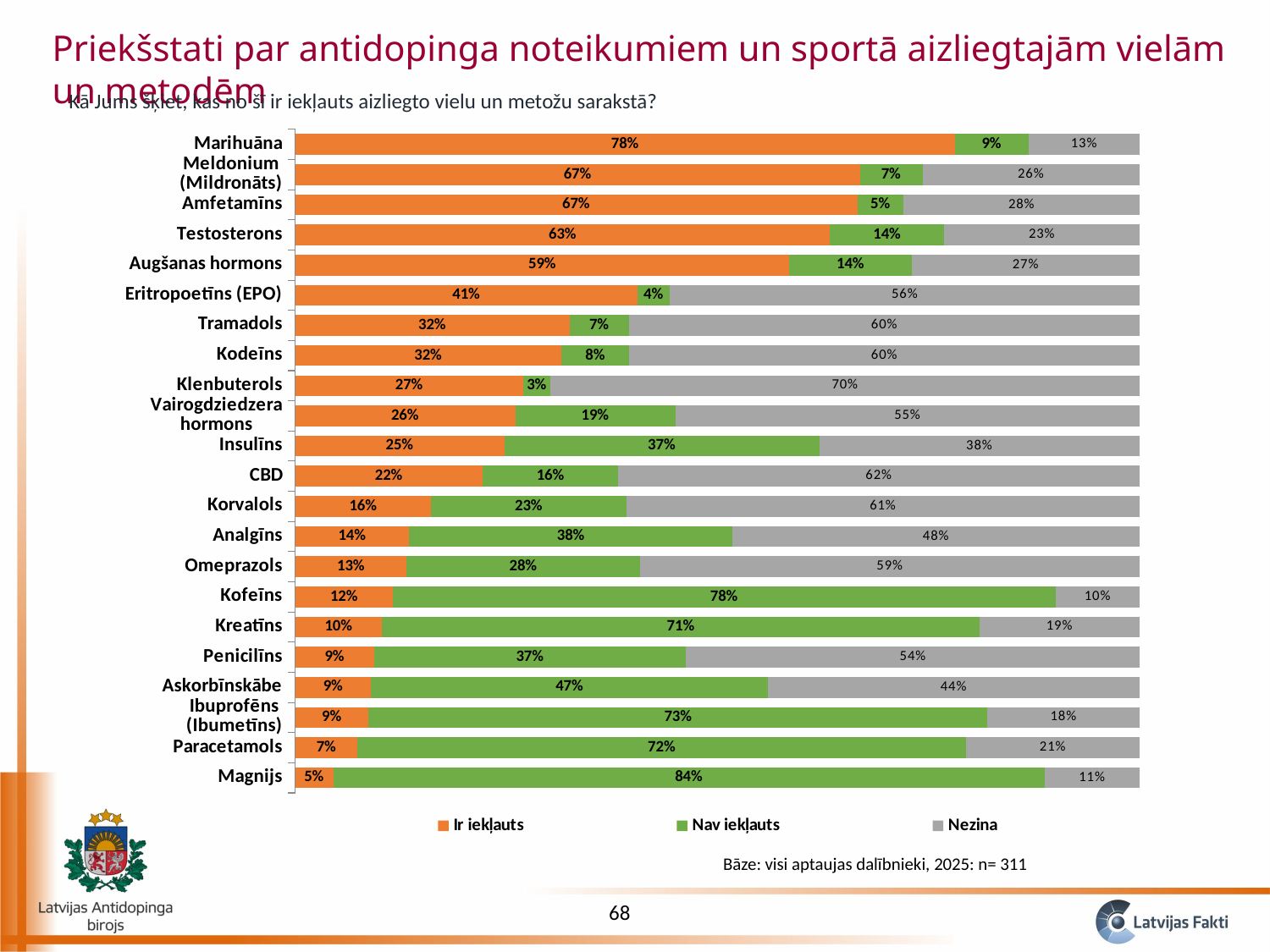
Which substance has the lowest Ir iekļauts percentage? Magnijs What is the difference between the Ir iekļauts values for Testosterons and Augšanas hormons? 4% Which has a larger Nezina value, Eritropoetīns (EPO) or Analgīns? Eritropoetīns (EPO) How many series does the legend list? 3 What is the Nezina value for Klenbuterols? 70% What type of chart is shown on the slide? Stacked bar chart What percentage of respondents said Marihuāna is included (Ir iekļauts) in the prohibited list? 78% What is the total of the stacked bar for Kofeīns? 100% Which substance has the highest Ir iekļauts percentage? Marihuāna Which substance has the highest Nav iekļauts percentage? Magnijs What is the Nav iekļauts value for Insulīns? 37% How many substances are listed in the chart? 22